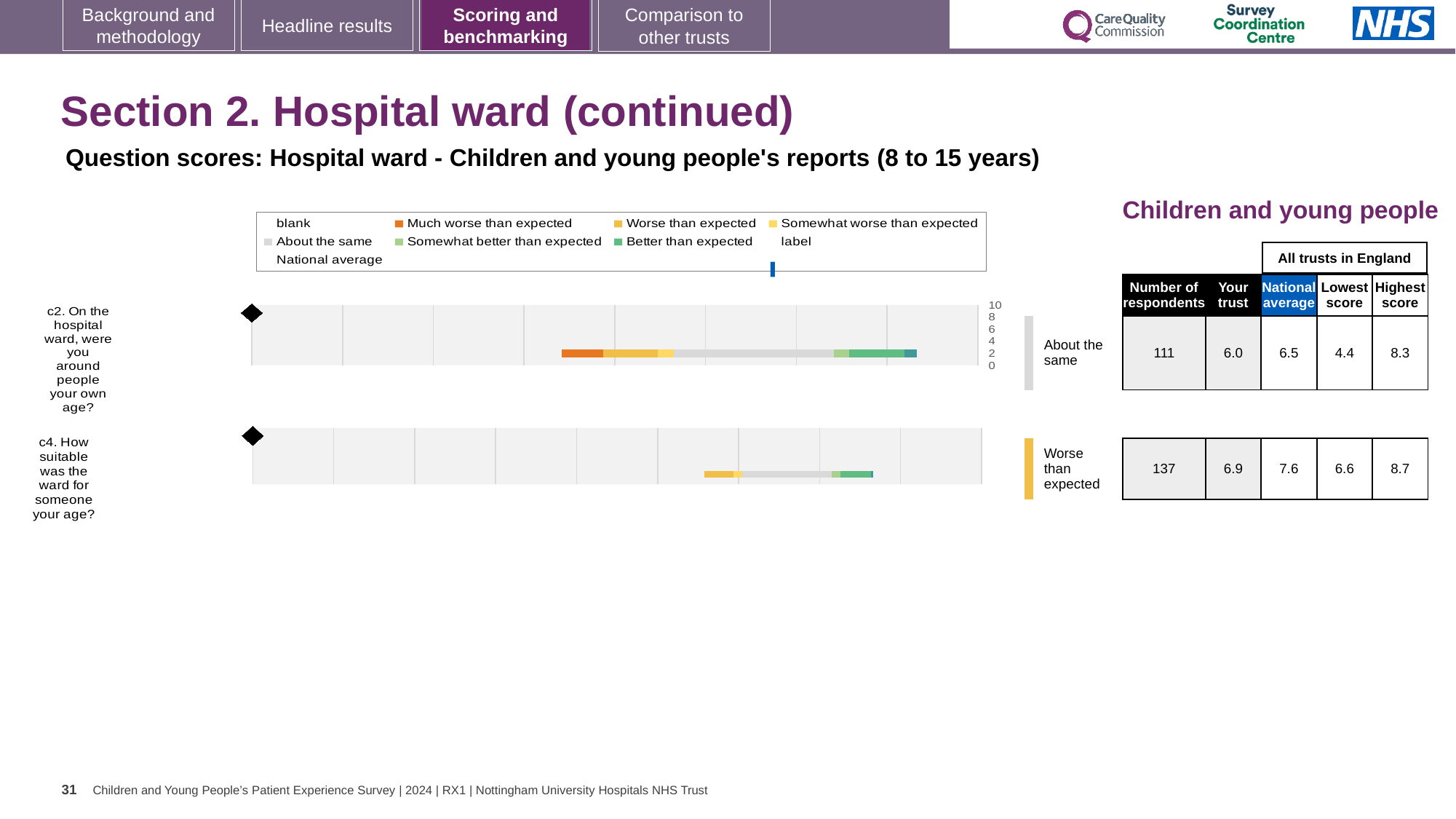
What is the benchmark rating shown for question c2 (On the hospital ward, were you around people your own age?)? About the same What is the 'Your trust' score for question c2? 6.0 Which legend entry is shown in dark orange? Much worse than expected What kind of chart is used to show the question scores on this slide? Bar chart What is the 'Your trust' score for question c4? 6.9 How many respondents answered question c2? 111 What is the difference between the highest score and the lowest score across all trusts in England for question c4? 2.1 What is the national average score for question c4? 7.6 How many questions are plotted in the chart on this slide? 2 What is the difference between the national average and the 'Your trust' score for question c2? 0.5 What is the benchmark rating shown for question c4 (How suitable was the ward for someone your age?)? Worse than expected Which question has the higher 'Your trust' score, c2 or c4? c4